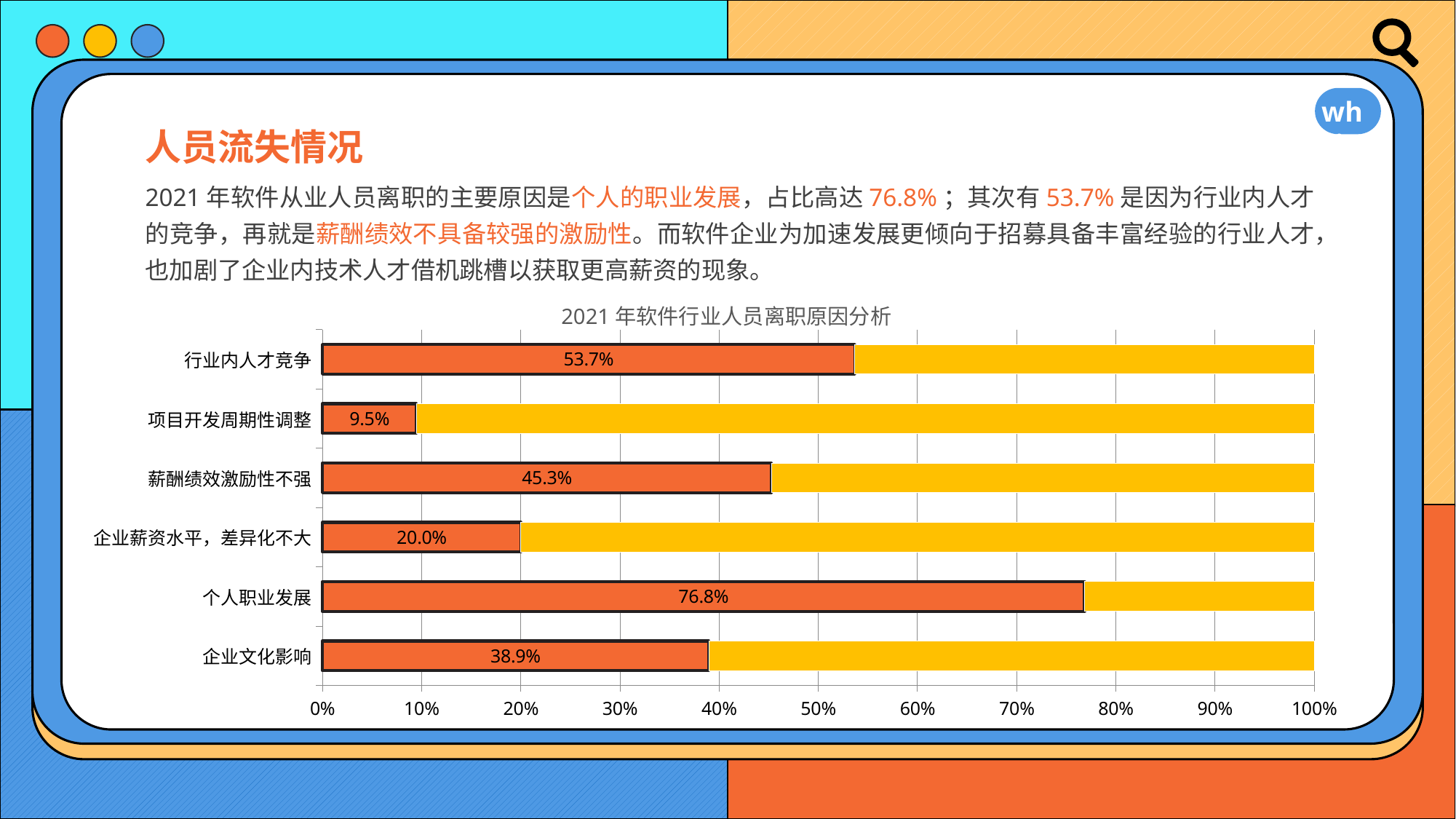
What is the value for 项目开发周期性调整? 9.5% What is the value for 薪酬绩效激励性不强? 45.3% What is the value for 个人职业发展? 76.8% What is the title of the chart? 2021 年软件行业人员离职原因分析 Which is larger, the value for 薪酬绩效激励性不强 or the value for 企业文化影响? 薪酬绩效激励性不强 What kind of chart is shown on the slide? bar chart How many categories are shown in the chart? 6 Which category has the lowest value? 项目开发周期性调整 Which category has the highest value? 个人职业发展 Is the value for 企业薪资水平，差异化不大 greater or less than 30%? less What is the difference between the values for 个人职业发展 and 行业内人才竞争? 23.1% What is the value for 企业文化影响? 38.9%